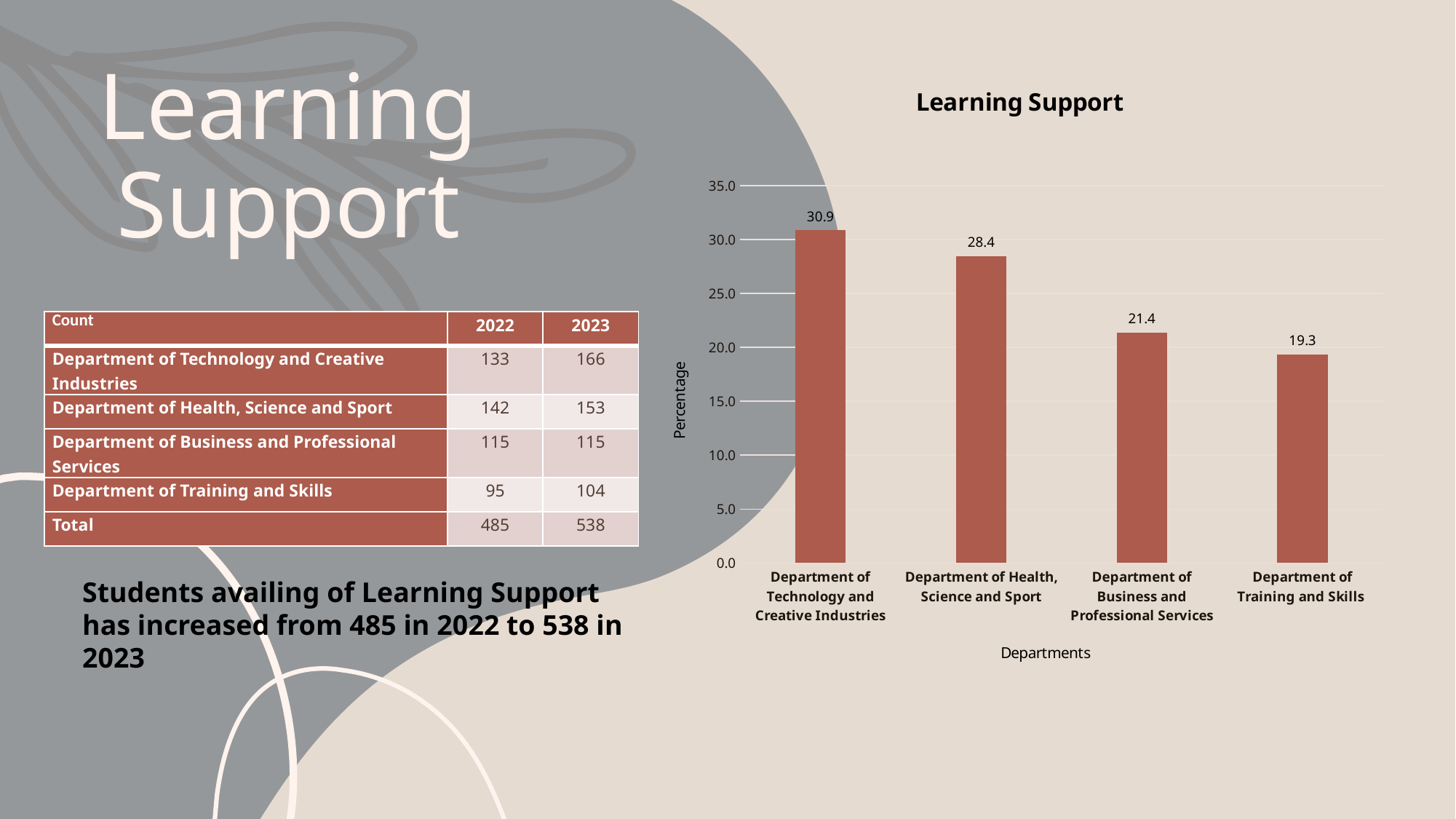
Which department has the lowest value in the Learning Support chart? Department of Training and Skills What is the value for the Department of Training and Skills in the Learning Support chart? 19.3 What kind of chart is the Learning Support chart? bar chart Which department has the highest value in the Learning Support chart? Department of Technology and Creative Industries Is the value for the Department of Business and Professional Services greater or less than 25.0 in the Learning Support chart? less What is the value for the Department of Business and Professional Services in the Learning Support chart? 21.4 What is the difference between the values for the Department of Technology and Creative Industries and the Department of Training and Skills in the Learning Support chart? 11.6 What is the value for the Department of Health, Science and Sport in the Learning Support chart? 28.4 What is the label on the vertical axis of the Learning Support chart? Percentage How many departments are shown in the Learning Support chart? 4 What is the value for the Department of Technology and Creative Industries in the Learning Support chart? 30.9 Which is larger in the Learning Support chart: the value for the Department of Health, Science and Sport or the Department of Business and Professional Services? Department of Health, Science and Sport